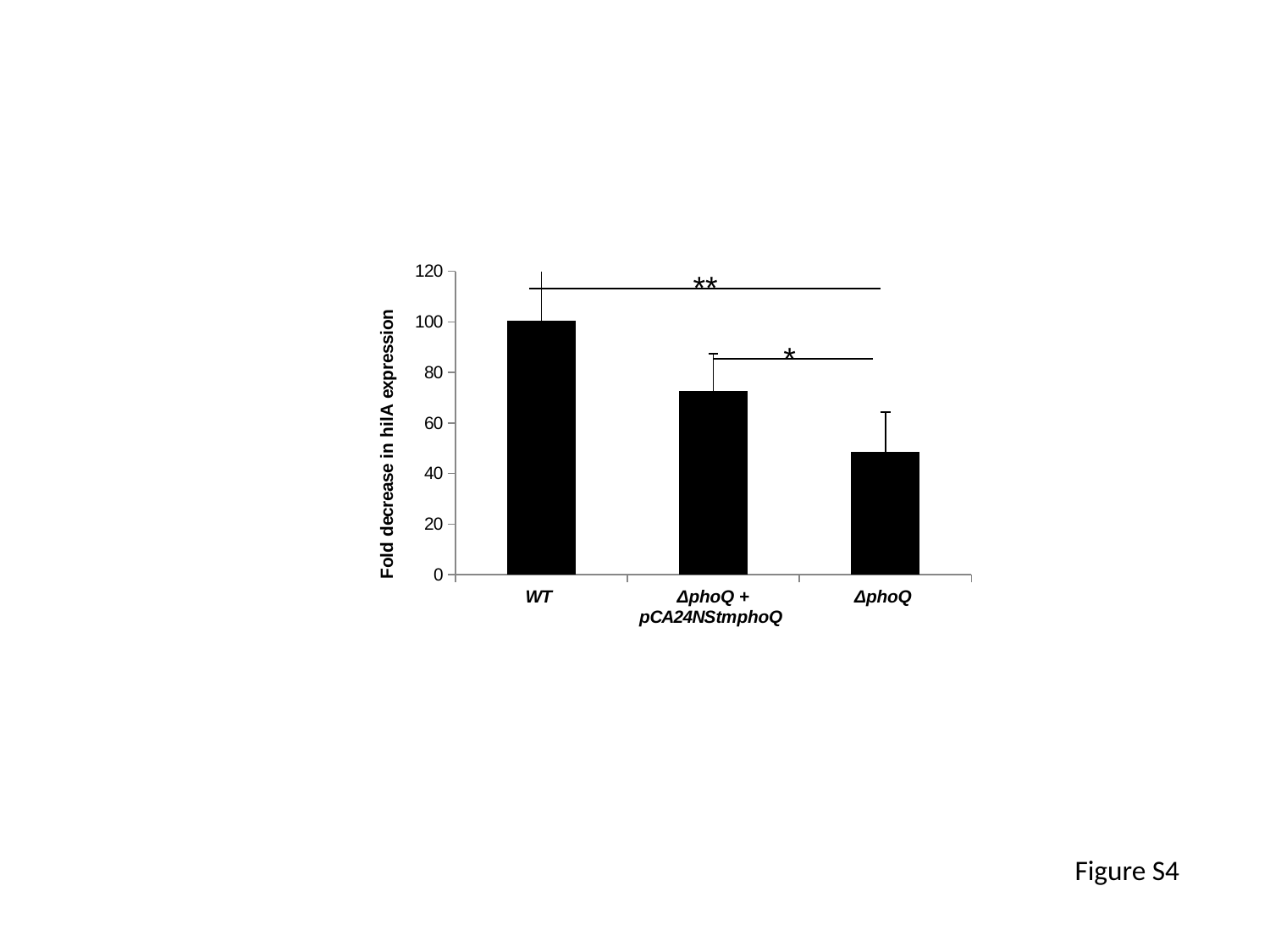
Is the value for ΔphoQ greater or less than 60? less Is the value for WT greater or less than 80? greater Is the value for ΔphoQ + pCA24NStmphoQ greater or less than 60? greater Which has the larger value, ΔphoQ + pCA24NStmphoQ or ΔphoQ? ΔphoQ + pCA24NStmphoQ Which category has the lowest fold decrease in hilA expression? ΔphoQ How many categories are plotted on the x axis? 3 Which has the larger value, WT or ΔphoQ? WT Which category has the highest fold decrease in hilA expression? WT What kind of chart is shown on the slide? bar chart What is the label of the y axis? Fold decrease in hilA expression Do the bar values rise or fall from left to right along the x axis? fall